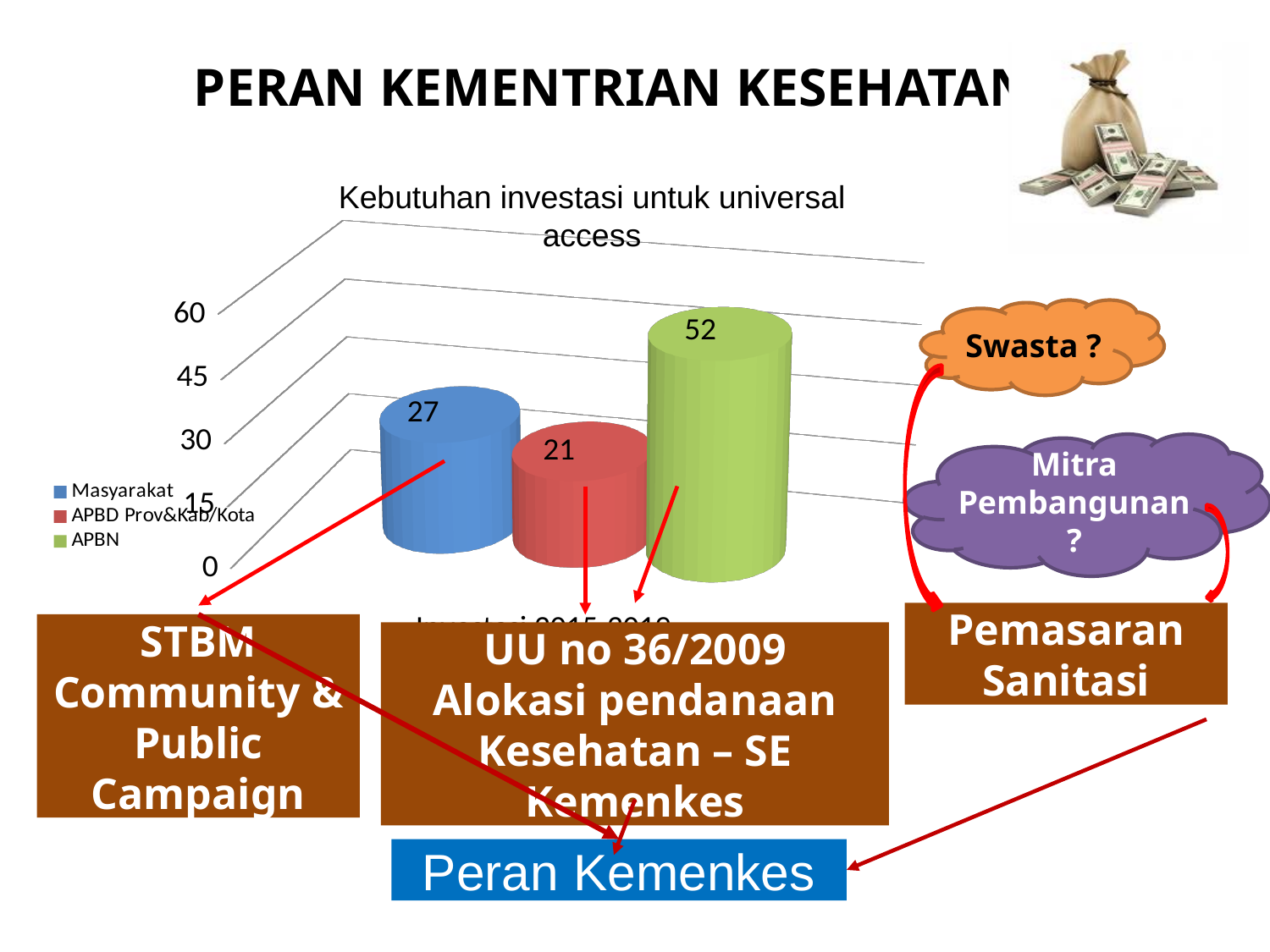
What is the value for APBD Prov&Kab/Kota in the chart? 21 What is the value for APBN in the chart? 52 How many series does the legend list? 3 What is the value for Masyarakat in the chart? 27 Which series has the highest value in the chart? APBN What kind of chart is shown on the slide? Bar chart Which series has the lowest value in the chart? APBD Prov&Kab/Kota What is the difference between the APBN value and the Masyarakat value? 25 What is the difference between the Masyarakat value and the APBD Prov&Kab/Kota value? 6 Is the value for APBN greater or less than 45? greater What is the title of the chart? Kebutuhan investasi untuk universal access Which is larger, the value for Masyarakat or the value for APBD Prov&Kab/Kota? Masyarakat